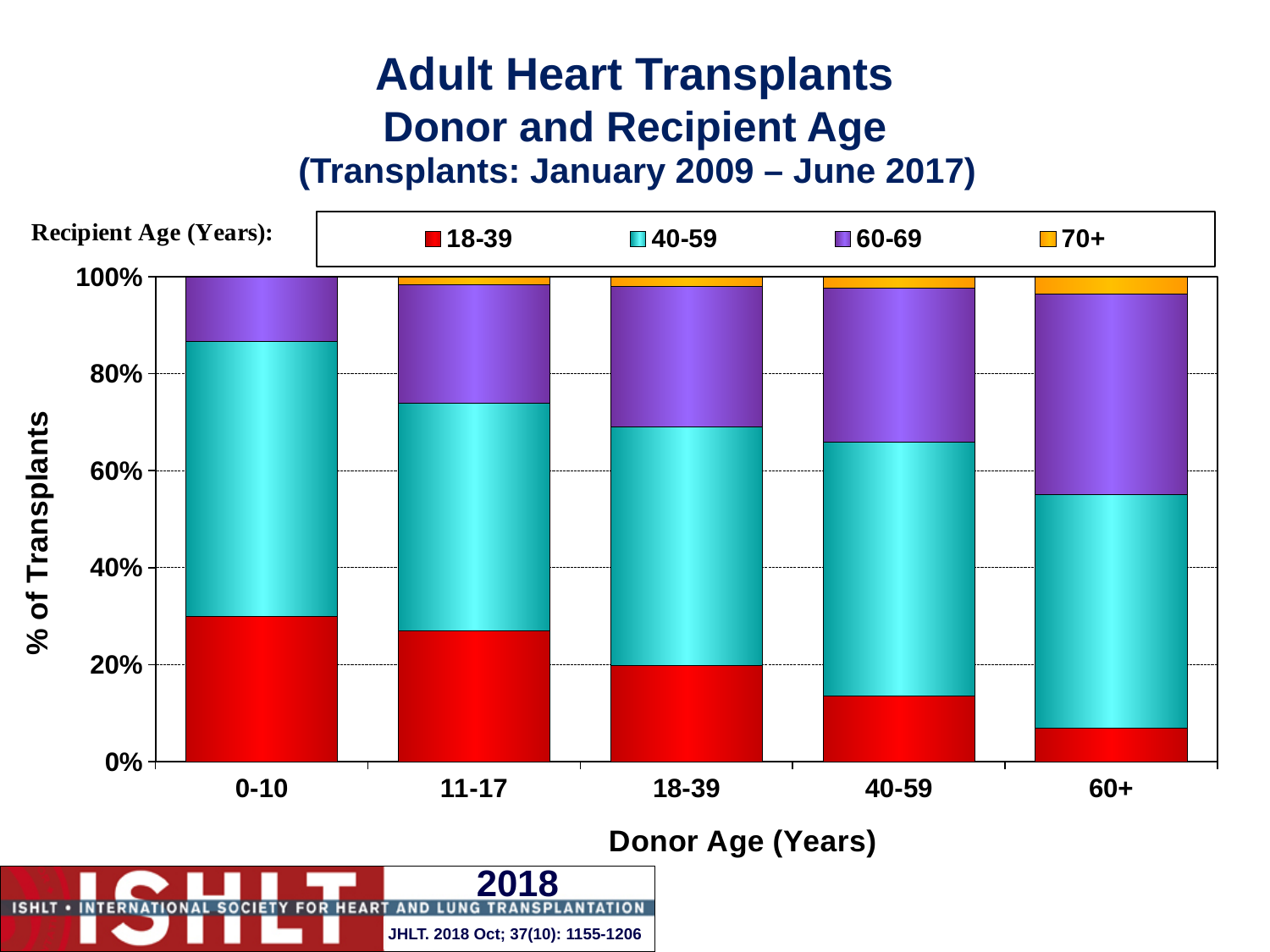
Which donor age group has the largest share of 18-39 year old recipients? 0-10 Is the share of 18-39 year old recipients for donor age 0-10 greater or less than 20%? greater What is the title of the x axis? Donor Age (Years) Is the share of 18-39 year old recipients for donor age 60+ greater or less than 20%? less Is the share of 40-59 year old recipients for donor age 0-10 greater or less than 40%? greater How many donor age categories are shown on the x axis? 5 Does the share of 18-39 year old recipients rise or fall as donor age increases along the x axis? Fall Which donor age group has the largest share of 60-69 year old recipients? 60+ How many recipient age series does the legend list? 4 Which donor age group has the smallest share of 18-39 year old recipients? 60+ What kind of chart is shown on the slide? Stacked bar chart Is the share of 60-69 year old recipients larger for donor age 60+ or for donor age 0-10? 60+